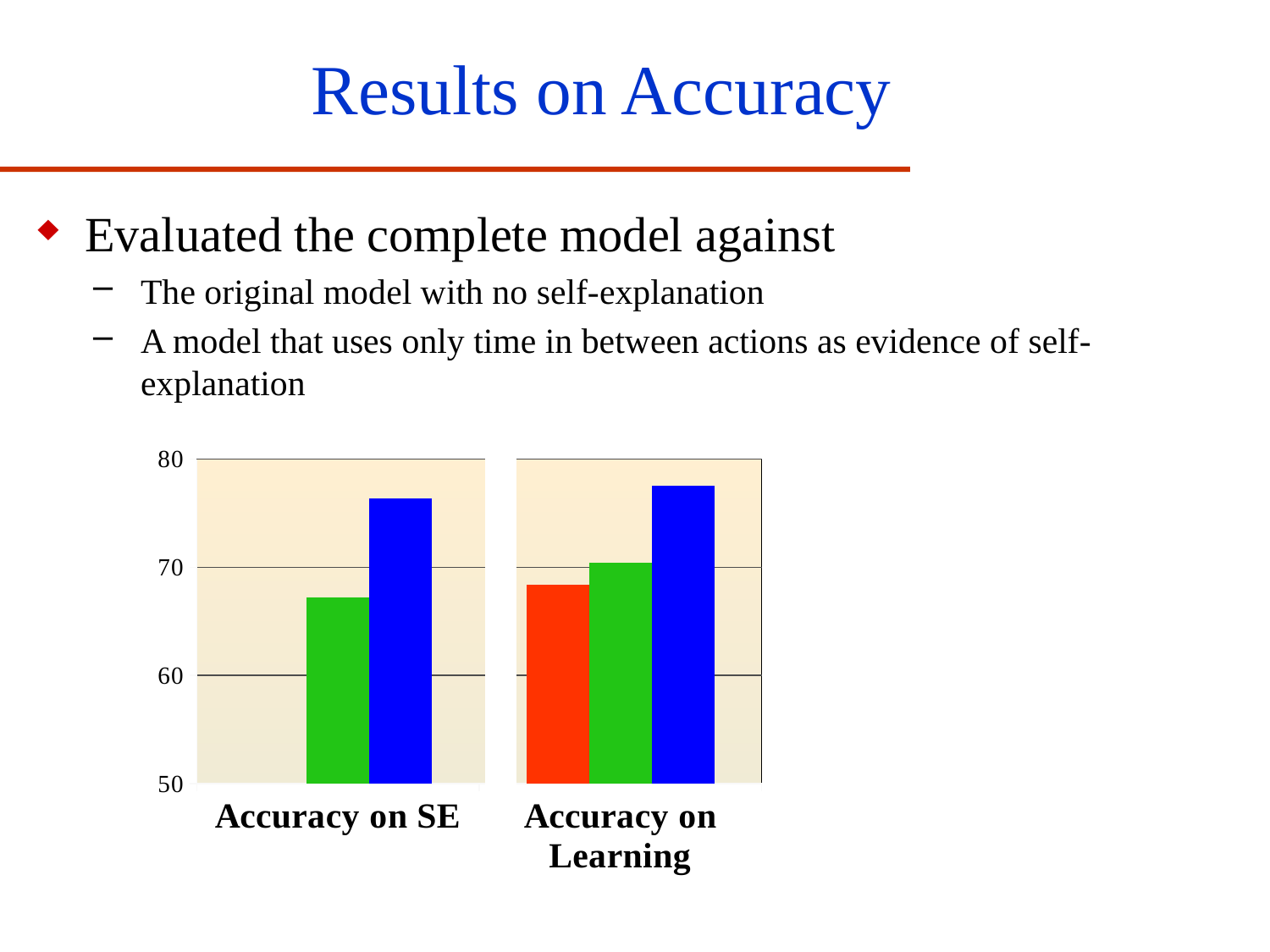
In the Accuracy on SE category, which bar is taller, the green one or the blue one? blue How many bars are plotted for the Accuracy on SE category? 2 How many categories are shown on the x axis of the chart? 2 In the Accuracy on Learning category, which bar is taller, the red one or the green one? green How many bars are plotted for the Accuracy on Learning category? 3 Is the value of the green bar for Accuracy on SE greater or less than 70? less Is the value of the blue bar for Accuracy on SE greater or less than 70? greater What kind of chart is shown on the slide? bar chart Is the value of the red bar for Accuracy on Learning greater or less than 70? less What is the lowest value shown on the chart's vertical axis? 50 Which bar is tallest in the Accuracy on Learning category: red, green or blue? blue